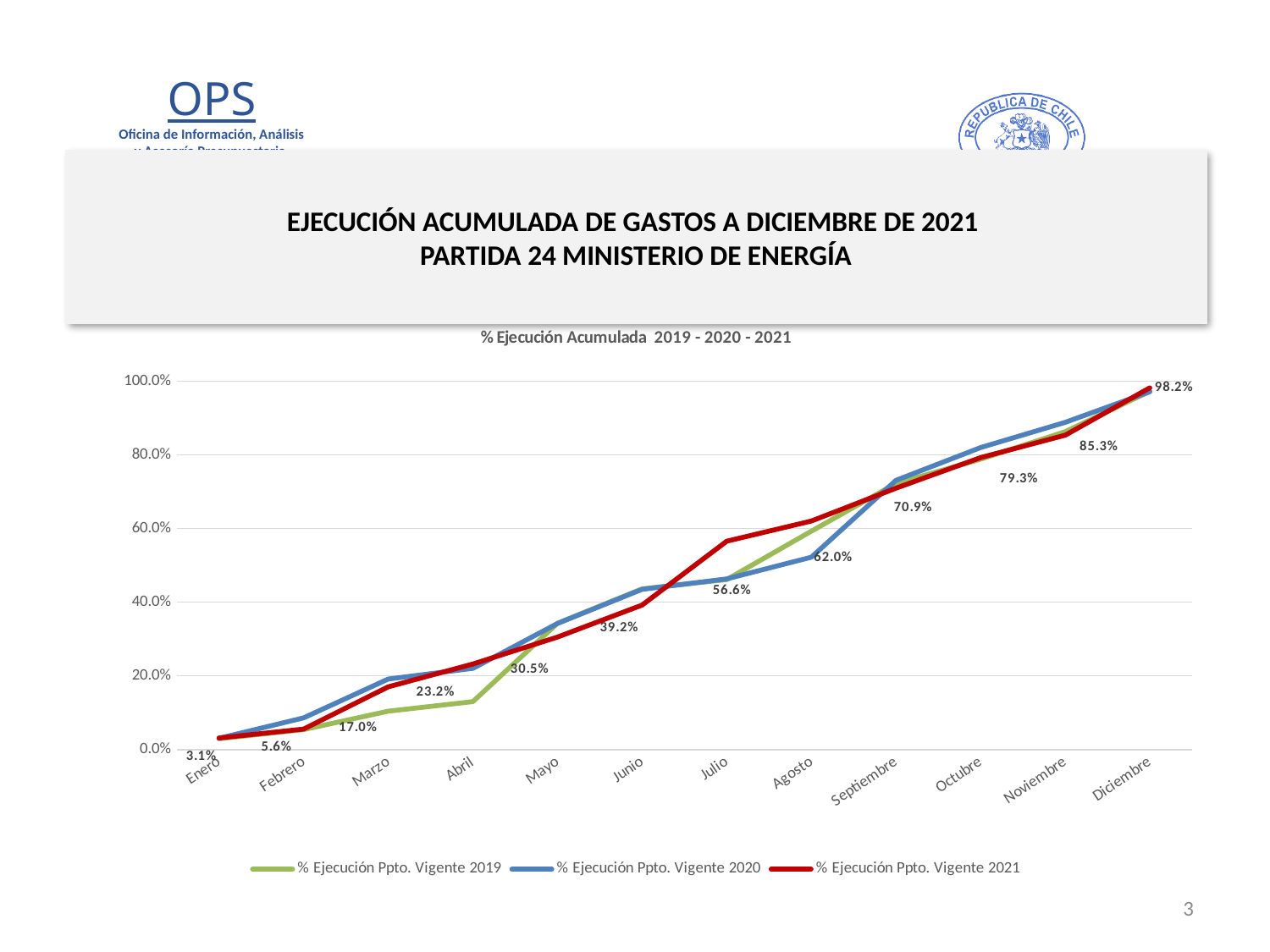
What is the value for % Ejecución Ppto. Vigente 2021 in Octubre? 79.3% What is the value for % Ejecución Ppto. Vigente 2021 in Diciembre? 98.2% What is the title of the chart? % Ejecución Acumulada 2019 - 2020 - 2021 In Julio, which series has the larger value: % Ejecución Ppto. Vigente 2021 or % Ejecución Ppto. Vigente 2020? % Ejecución Ppto. Vigente 2021 What is the difference between the % Ejecución Ppto. Vigente 2021 values for Diciembre and Noviembre? 12.9% What is the value for % Ejecución Ppto. Vigente 2021 in Julio? 56.6% What kind of chart is shown on the slide? line chart How many months are shown along the x axis? 12 Do the % Ejecución Ppto. Vigente 2021 values rise or fall from Enero to Diciembre? rise What is the value for % Ejecución Ppto. Vigente 2021 in Marzo? 17.0% How many series does the legend list? 3 In which month is the % Ejecución Ppto. Vigente 2021 value lowest? Enero